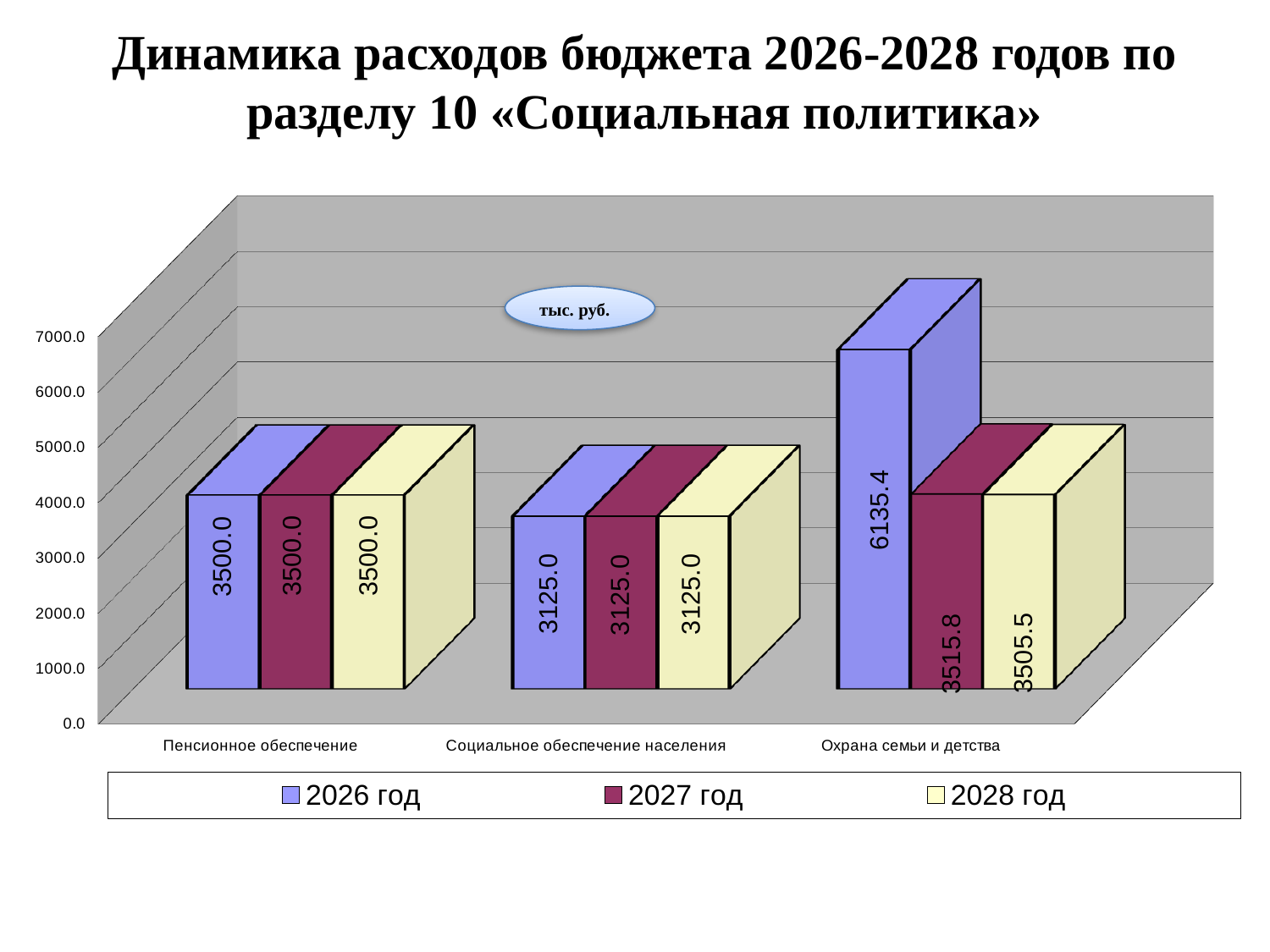
Which category has the highest value in 2026 год? Охрана семьи и детства What kind of chart is shown on the slide? bar chart How many series does the legend list? 3 How many categories are shown on the x axis? 3 Which category has the lowest value in 2027 год? Социальное обеспечение населения What is the difference between the 2026 год and 2027 год values for Охрана семьи и детства? 2619.6 What is the value for Охрана семьи и детства in 2028 год? 3505.5 What is the value for Пенсионное обеспечение in 2027 год? 3500.0 Which is larger for 2028 год: Пенсионное обеспечение or Охрана семьи и детства? Охрана семьи и детства What is the value for Социальное обеспечение населения in 2028 год? 3125.0 Is the value for Охрана семьи и детства in 2026 год greater or less than 6000? greater What is the value for Охрана семьи и детства in 2026 год? 6135.4